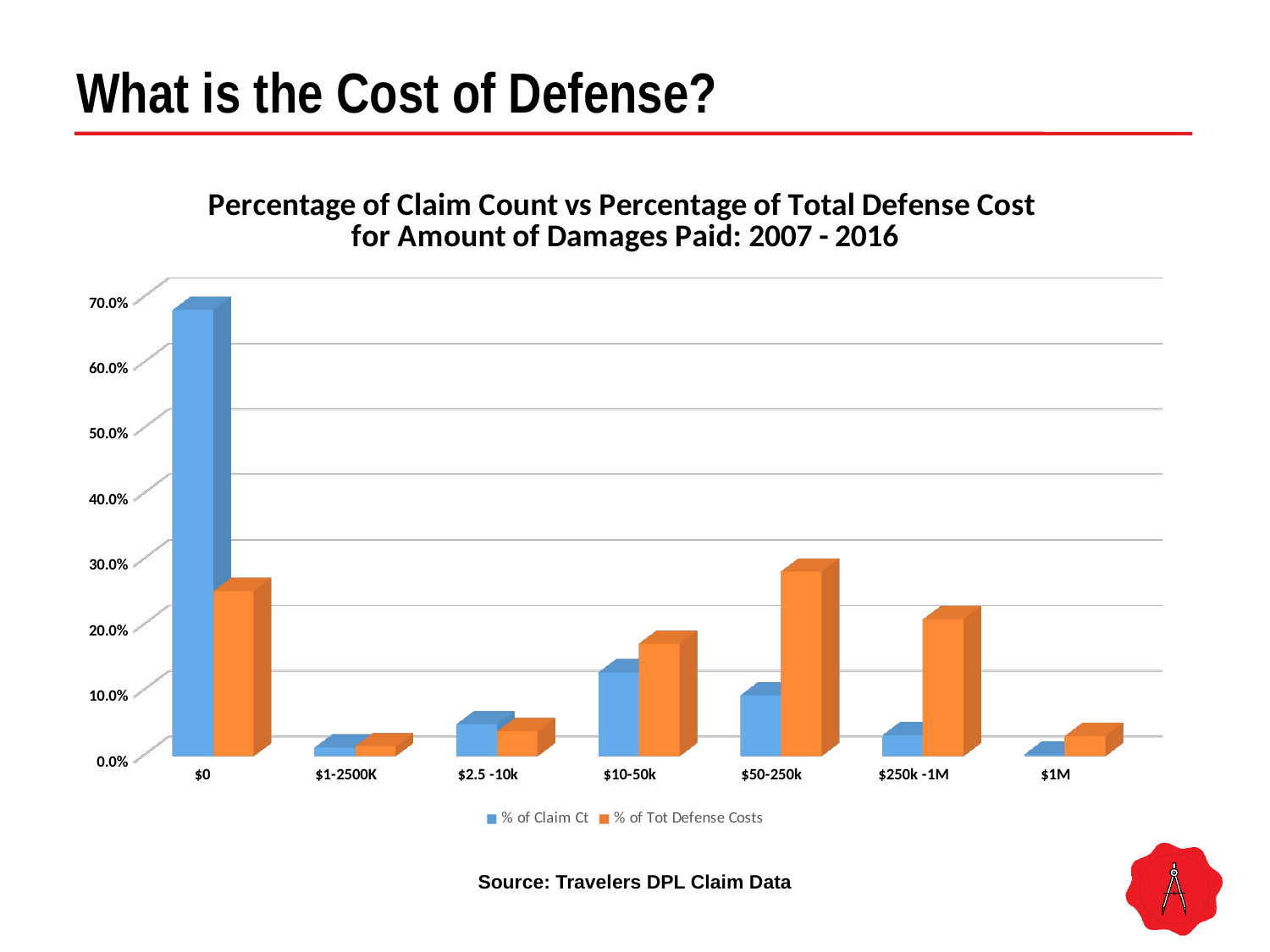
For the $50-250k category, which is larger: % of Claim Ct or % of Tot Defense Costs? % of Tot Defense Costs How many series does the legend list? 2 Is the % of Tot Defense Costs for $50-250k greater or less than 20.0%? greater Which category has the lowest % of Claim Ct? $1M What colour represents the % of Claim Ct series? blue Which category has the highest % of Tot Defense Costs? $50-250k Which category has the highest % of Claim Ct? $0 Is the % of Claim Ct for $10-50k greater or less than 10.0%? greater How many damage-amount categories are shown on the x axis? 7 Is the % of Claim Ct for $0 greater or less than 60.0%? greater What kind of chart is shown on the slide? bar chart